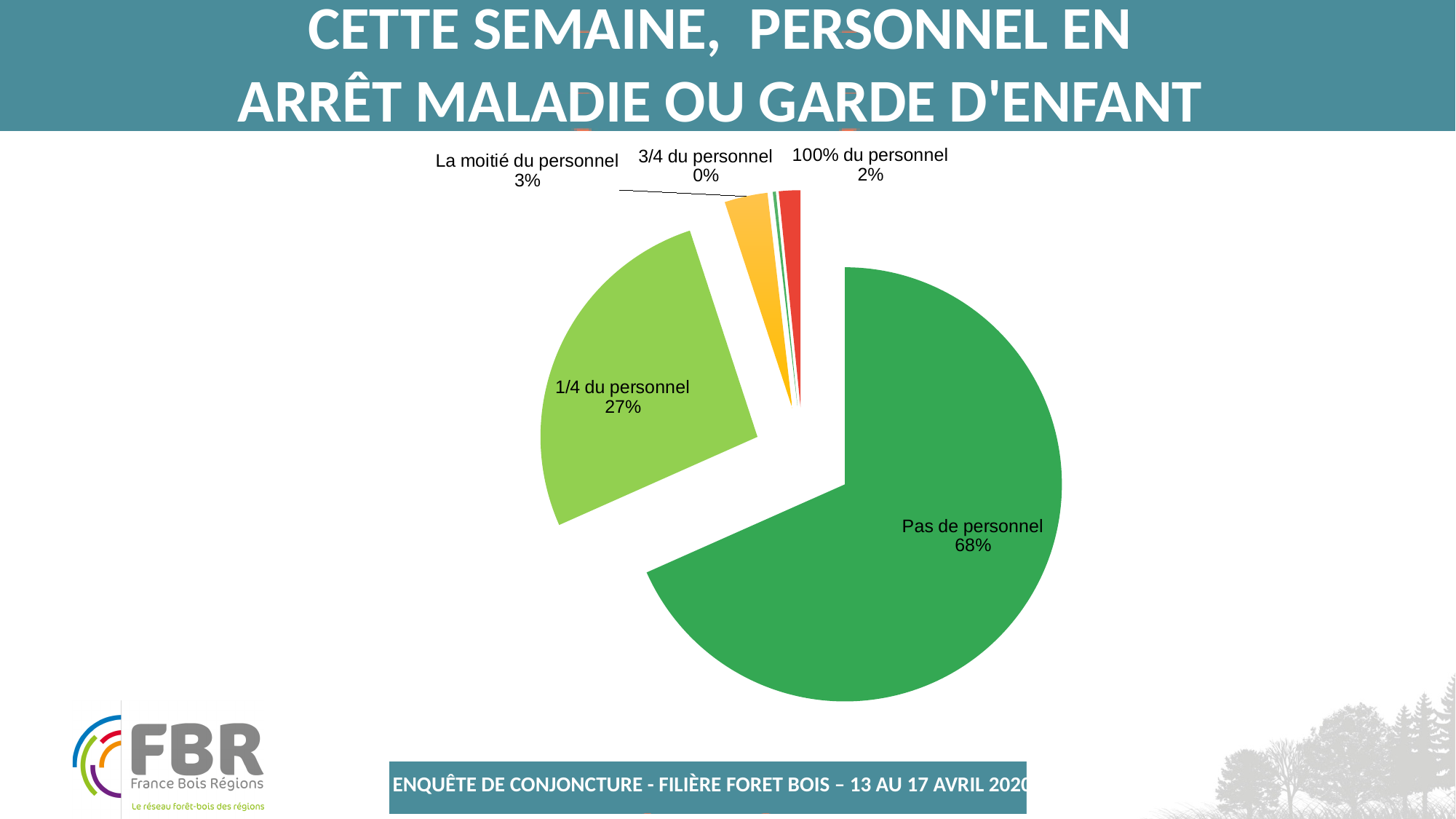
What colour is the slice for "Pas de personnel"? green What share of the pie is labelled "3/4 du personnel"? 0% What is the difference in percentage points between "Pas de personnel" and "1/4 du personnel"? 41 Which category has the largest slice of the pie? Pas de personnel What kind of chart is shown on the slide? pie chart What share of the pie is labelled "1/4 du personnel"? 27% Which category has the smallest slice of the pie? 3/4 du personnel What share of the pie is labelled "La moitié du personnel"? 3% How many categories are shown in the pie chart? 5 Which is larger, the slice for "La moitié du personnel" or the slice for "100% du personnel"? La moitié du personnel